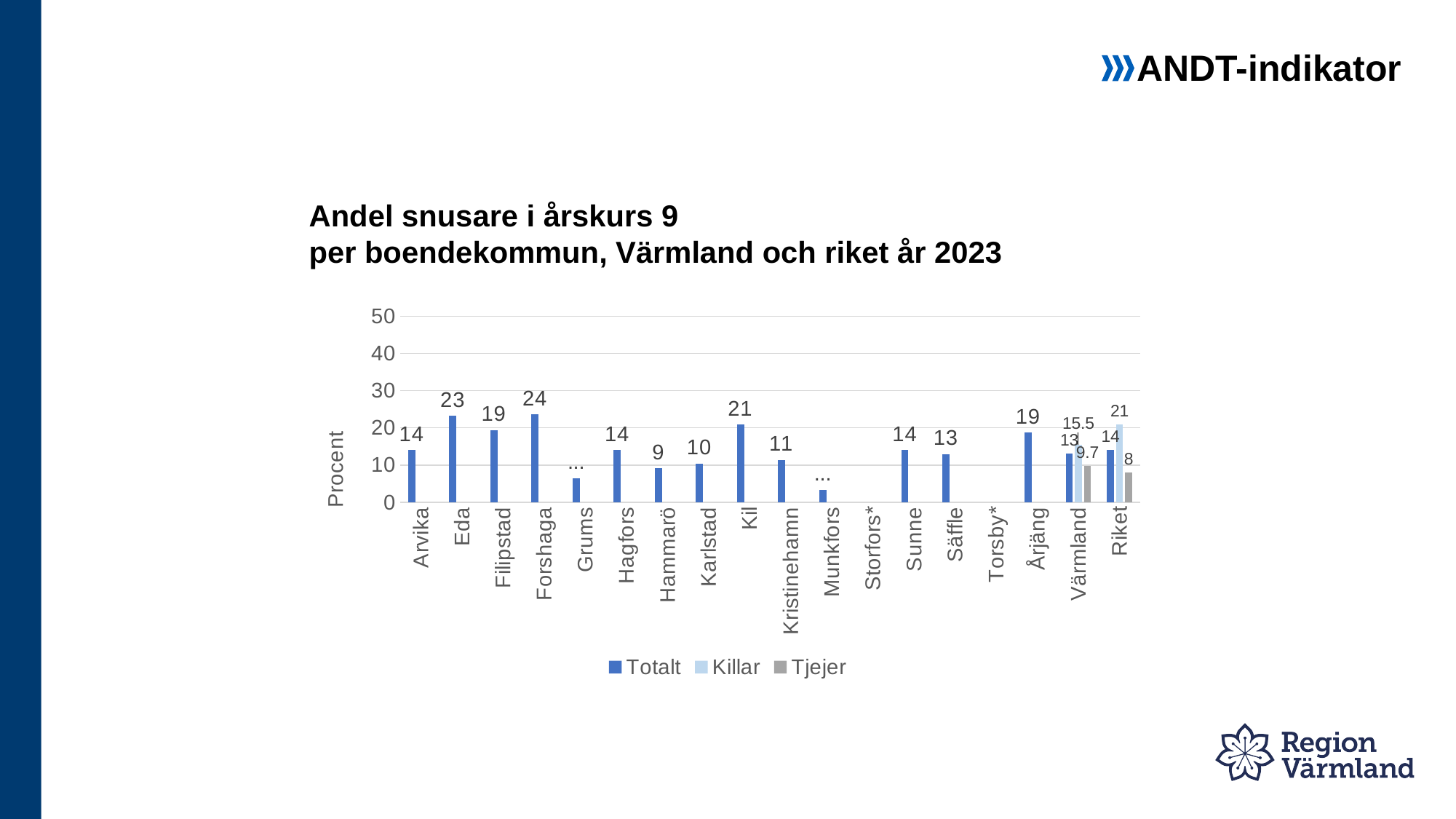
What is the Tjejer value for Värmland? 9.7 Is the Totalt value for Grums greater or less than 10? less What kind of chart is shown on the slide? Bar chart How many series does the legend list? 3 Which has a larger Totalt value, Kil or Kristinehamn? Kil What is the Totalt value for Hammarö? 9 What is the difference between the Killar and Tjejer values for Riket? 13 What is the label on the vertical axis? Procent What is the Totalt value for Forshaga? 24 Which municipality has the highest Totalt value? Forshaga What is the Killar value for Riket? 21 What is the difference between the Totalt values for Eda and Arvika? 9